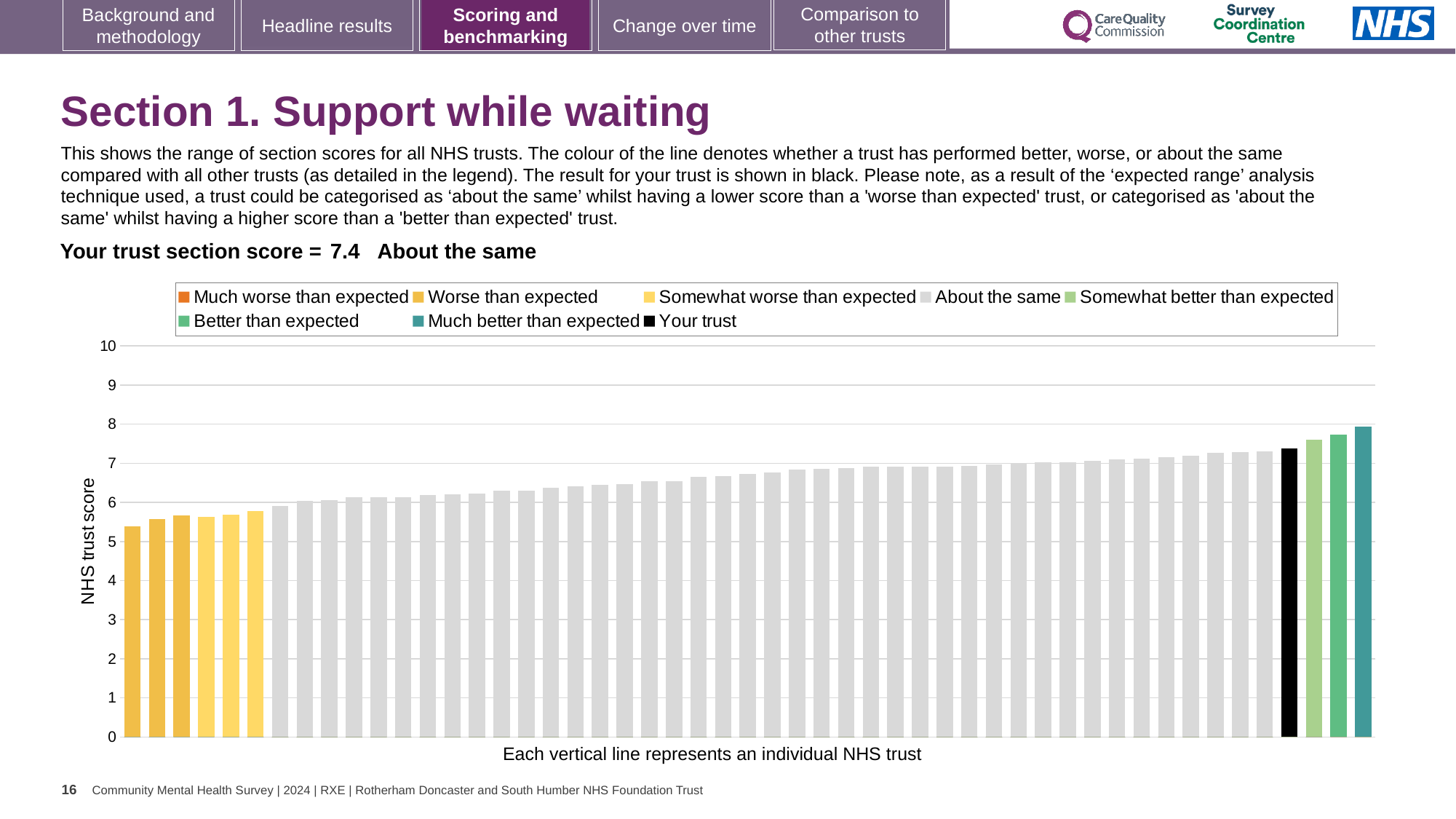
What kind of chart is shown on the slide? Bar chart According to the legend, what colour is used for 'Your trust'? Black Is the value of the black 'Your trust' bar greater or less than 8? less Is the value of the black 'Your trust' bar greater or less than 7? greater Which legend category does the tallest bar belong to? Much better than expected What is the section score for your trust shown on the slide? 7.4 Do the bar values rise or fall from left to right along the x axis? rise How many entries does the chart legend list? 8 What is the label on the vertical axis of the chart? NHS trust score Which is taller: the black 'Your trust' bar or the leftmost bar? The black 'Your trust' bar Which category is your trust placed in for this section? About the same Is the value of the leftmost bar greater or less than 6? less